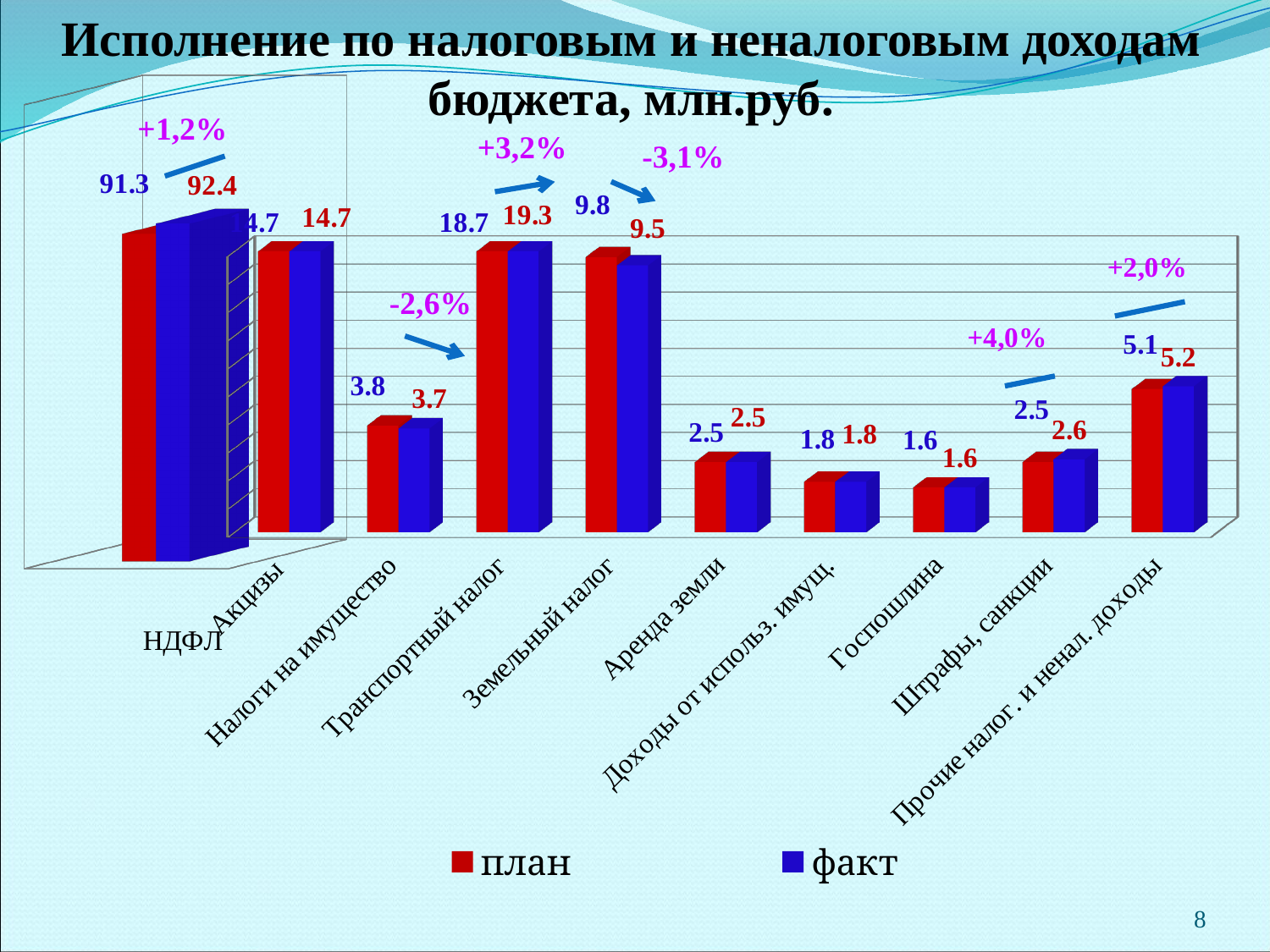
What is the план value for Транспортный налог? 18.7 What are the two entries in the legend? план, факт What kind of chart is shown on the slide? bar chart Which category has the lowest values? Госпошлина How many series does the legend list? 2 What is the факт value for Акцизы? 14.7 Which has the larger план value, Транспортный налог or Земельный налог? Транспортный налог What percentage change is annotated above Штрафы, санкции? +4,0% Which category has the highest values? НДФЛ How many categories are shown on the x axis? 10 What is the факт value for Земельный налог? 9.5 What is the difference between the факт and план values for НДФЛ? 1.1